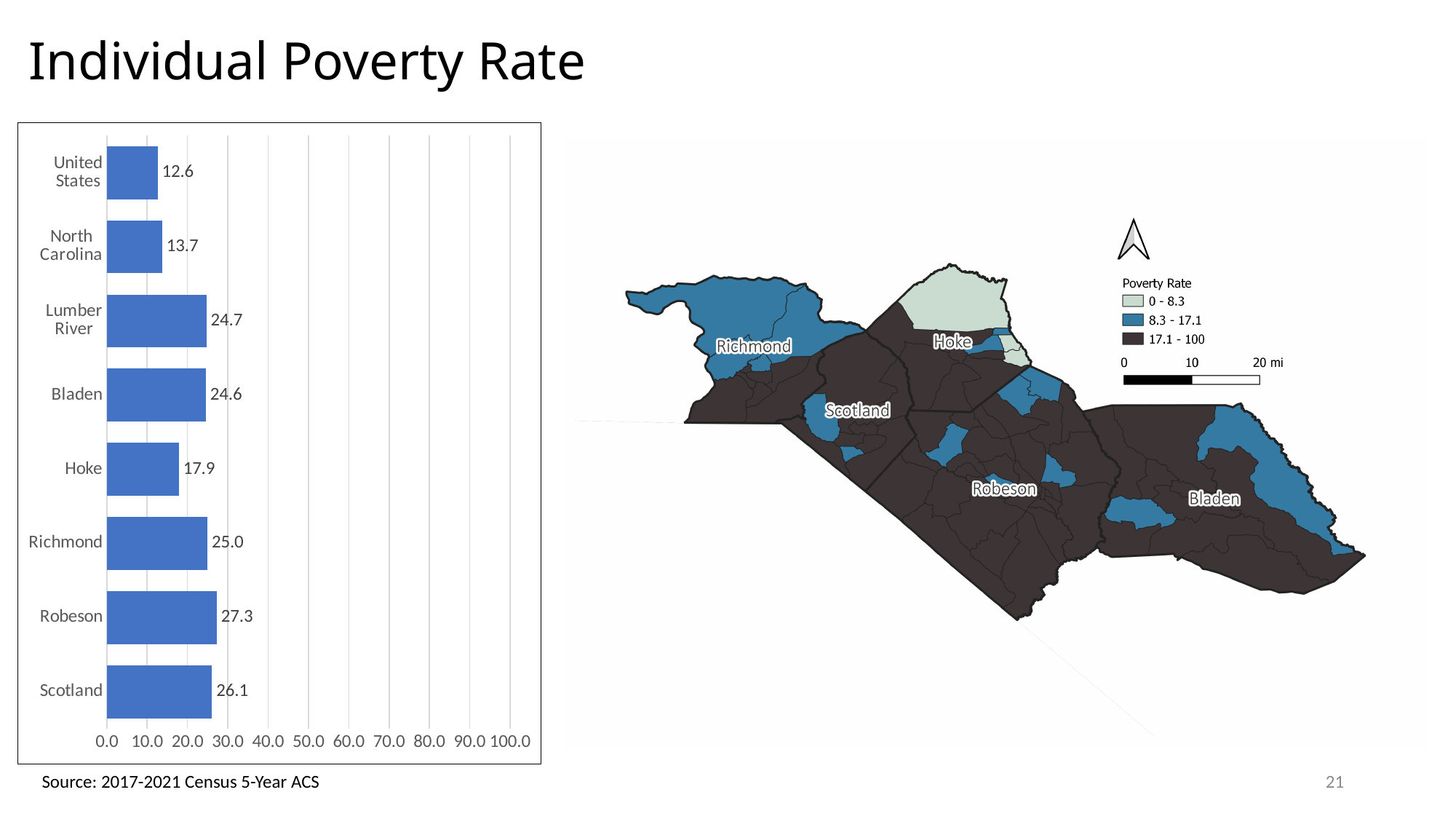
Which category has the highest value in the bar chart? Robeson How many categories are shown in the bar chart? 8 What kind of chart is used to show the individual poverty rates? bar chart Is the value for Scotland greater or less than 20.0? greater Which has a larger value, Richmond or Hoke? Richmond Which category has the lowest value in the bar chart? United States What is the difference between the values for Robeson and Scotland? 1.2 What is the difference between the values for Hoke and North Carolina? 4.2 What is the highest value labelled on the x axis of the bar chart? 100.0 What is the individual poverty rate shown for Robeson? 27.3 What is the value shown for Hoke? 17.9 What value is shown for North Carolina in the bar chart? 13.7